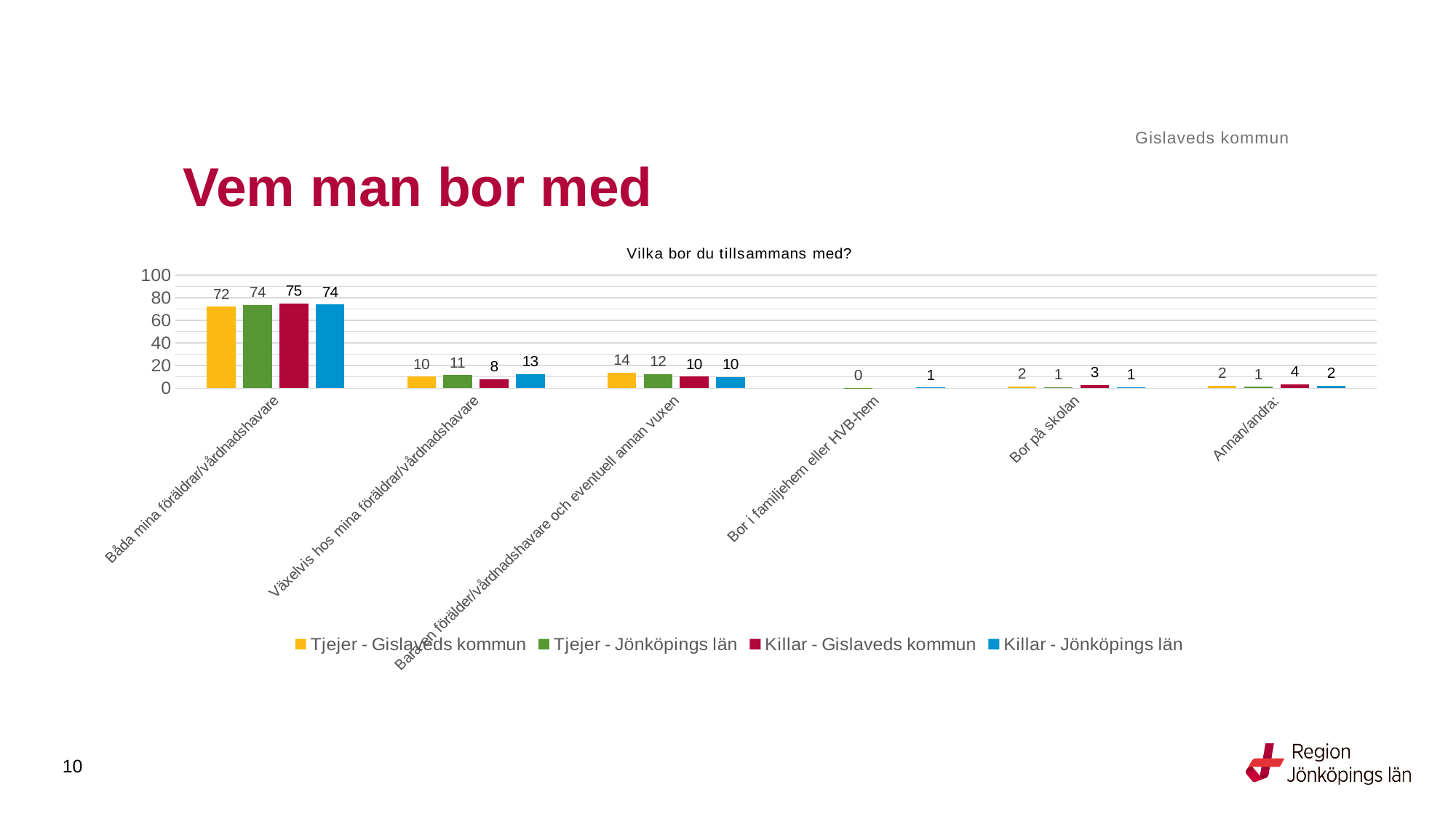
What is the title of the chart? Vilka bor du tillsammans med? Which is larger in the category Annan/andra: Killar - Gislaveds kommun or Tjejer - Jönköpings län? Killar - Gislaveds kommun What is the value for Tjejer - Gislaveds kommun in the category Bara en förälder/vårdnadshavare och eventuell annan vuxen? 14 What is the value for Killar - Jönköpings län in the category Växelvis hos mina föräldrar/vårdnadshavare? 13 What is the difference between Killar - Jönköpings län and Killar - Gislaveds kommun in the category Växelvis hos mina föräldrar/vårdnadshavare? 5 What is the value for Killar - Gislaveds kommun in the category Båda mina föräldrar/vårdnadshavare? 75 Which category has the highest values across all series? Båda mina föräldrar/vårdnadshavare How many series does the legend list? 4 What is the value for Killar - Gislaveds kommun in the category Bor på skolan? 3 Is the value for Tjejer - Gislaveds kommun in the category Båda mina föräldrar/vårdnadshavare greater or less than 60? greater What type of chart is shown on the slide? bar chart How many categories are shown on the x axis? 6